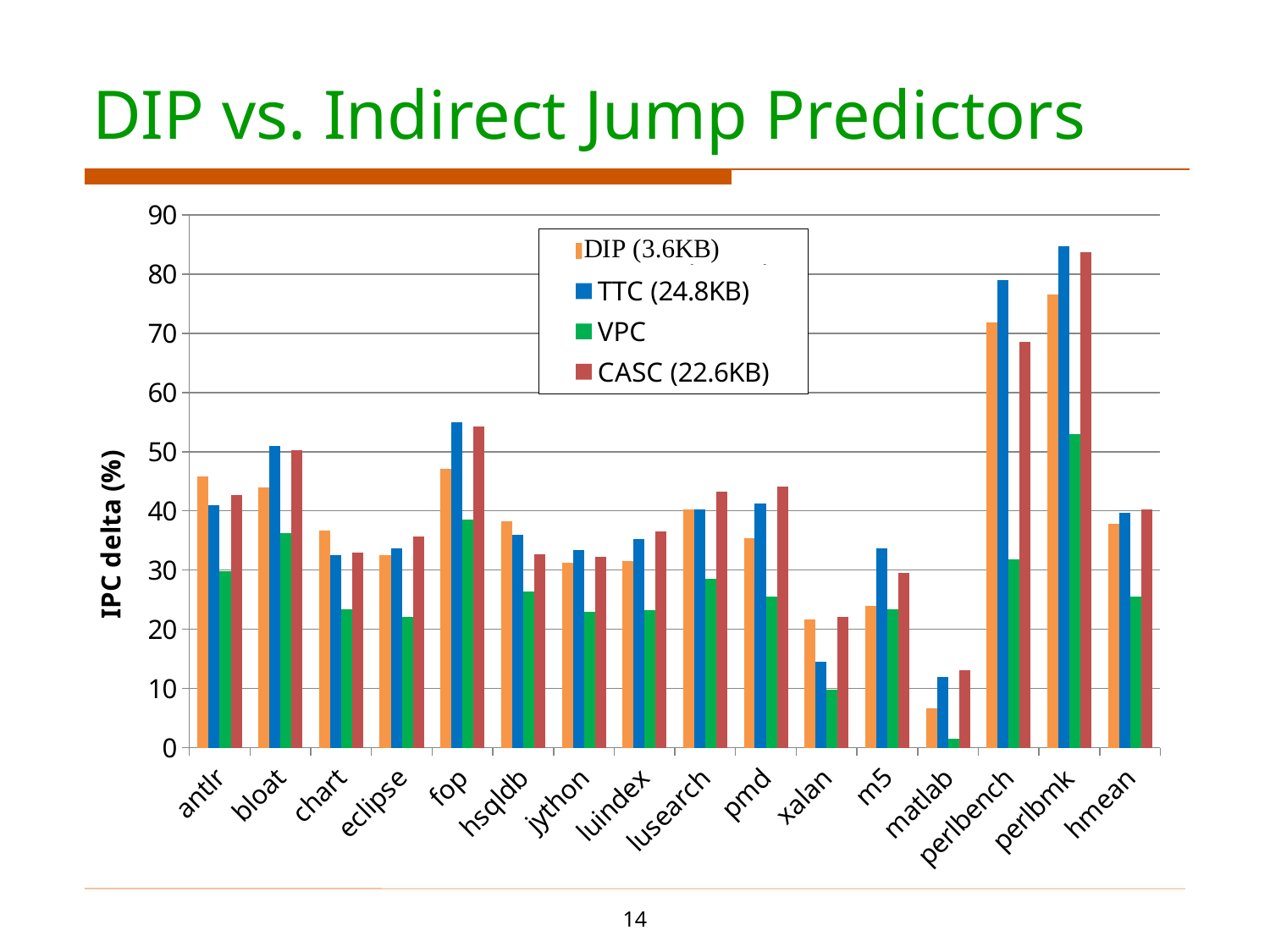
Which category has the highest TTC (24.8KB) bar? perlbmk How many series does the legend list? 4 For antlr, which is larger: the DIP (3.6KB) value or the TTC (24.8KB) value? DIP (3.6KB) Is the VPC value for eclipse greater or less than 30? less How many benchmark categories are shown along the x axis? 16 Is the VPC value for matlab greater or less than 10? less Is the DIP (3.6KB) value for perlbench greater or less than 70? greater Which category has the lowest VPC bar? matlab What kind of chart is shown on the slide? bar chart For pmd, which is larger: the CASC (22.6KB) value or the VPC value? CASC (22.6KB) What is the label of the y axis? IPC delta (%)